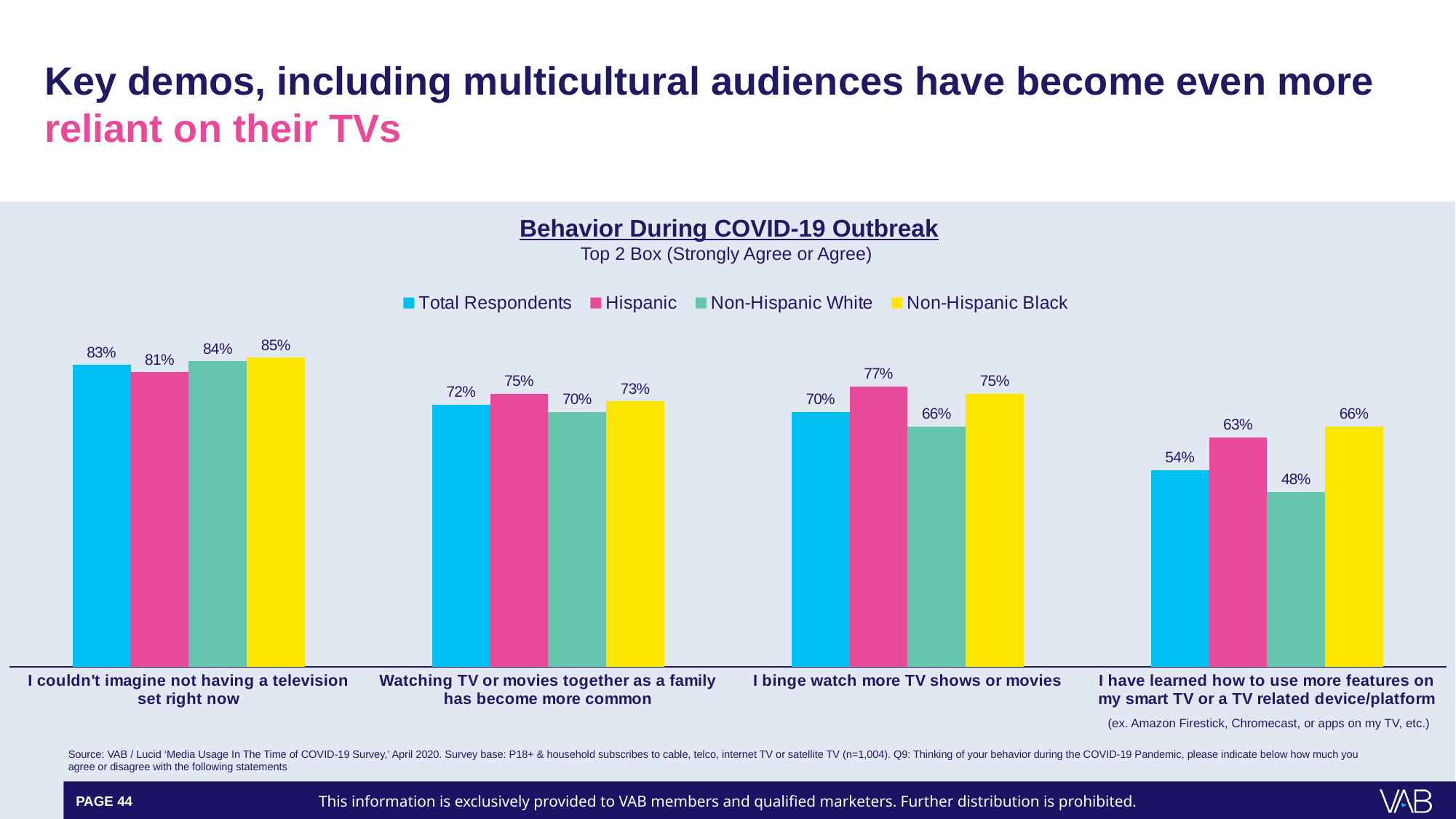
What is the value for Non-Hispanic White respondents for "I have learned how to use more features on my smart TV or a TV related device/platform"? 48% What is the title of the chart? Behavior During COVID-19 Outbreak How many statement categories are shown on the x axis? 4 Which group has the lowest value for "I have learned how to use more features on my smart TV or a TV related device/platform"? Non-Hispanic White Which group has the highest value for "I couldn't imagine not having a television set right now"? Non-Hispanic Black Do the Total Respondents values rise or fall across the categories from left to right? Fall What percentage of Hispanic respondents agreed with "I binge watch more TV shows or movies"? 77% What is the difference between the Hispanic and Non-Hispanic White values for "I binge watch more TV shows or movies"? 11 percentage points What kind of chart is shown on the slide? Bar chart How many series does the legend list? 4 For "Watching TV or movies together as a family has become more common", which is larger: the Hispanic value or the Non-Hispanic Black value? Hispanic What is the Total Respondents value for "Watching TV or movies together as a family has become more common"? 72%